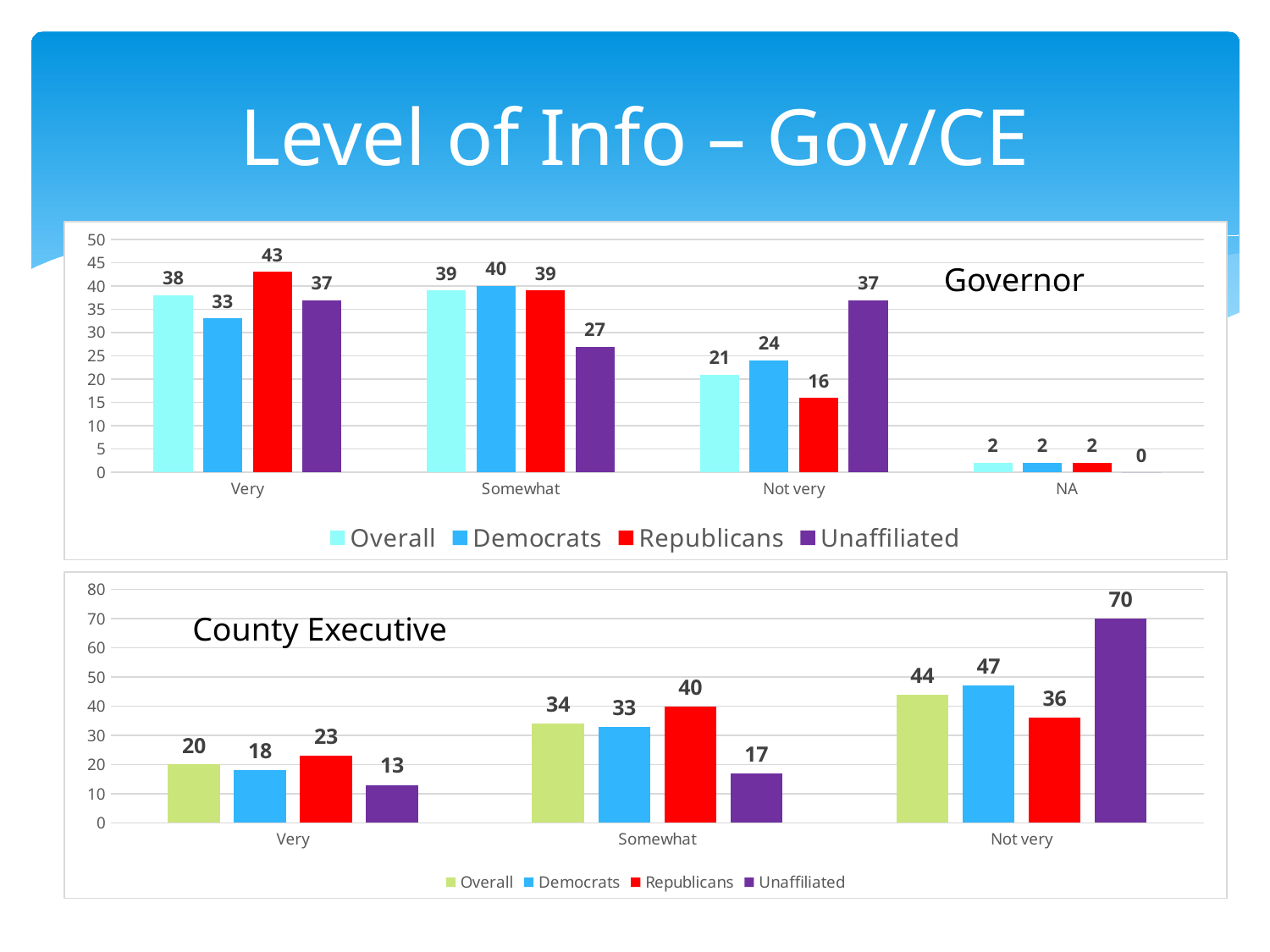
In the County Executive chart, what is the value for Unaffiliated in the Not very category? 70 In the County Executive chart, which category has the highest value for Overall? Not very What type of chart is the County Executive chart? Bar chart In the Governor chart, which category has the lowest value for Unaffiliated? NA In the County Executive chart, what is the difference between the Republicans and Unaffiliated values in the Very category? 10 How many series does the legend of the County Executive chart list? 4 In the County Executive chart, which is larger in the Somewhat category: Republicans or Unaffiliated? Republicans In the Governor chart, what is the value for Unaffiliated in the Not very category? 37 In the Governor chart, what is the value for Republicans in the Very category? 43 In the Governor chart, what is the difference between the Unaffiliated and Republicans values in the Not very category? 21 How many categories are shown on the x axis of the Governor chart? 4 In the County Executive chart, what is the value for Democrats in the Somewhat category? 33